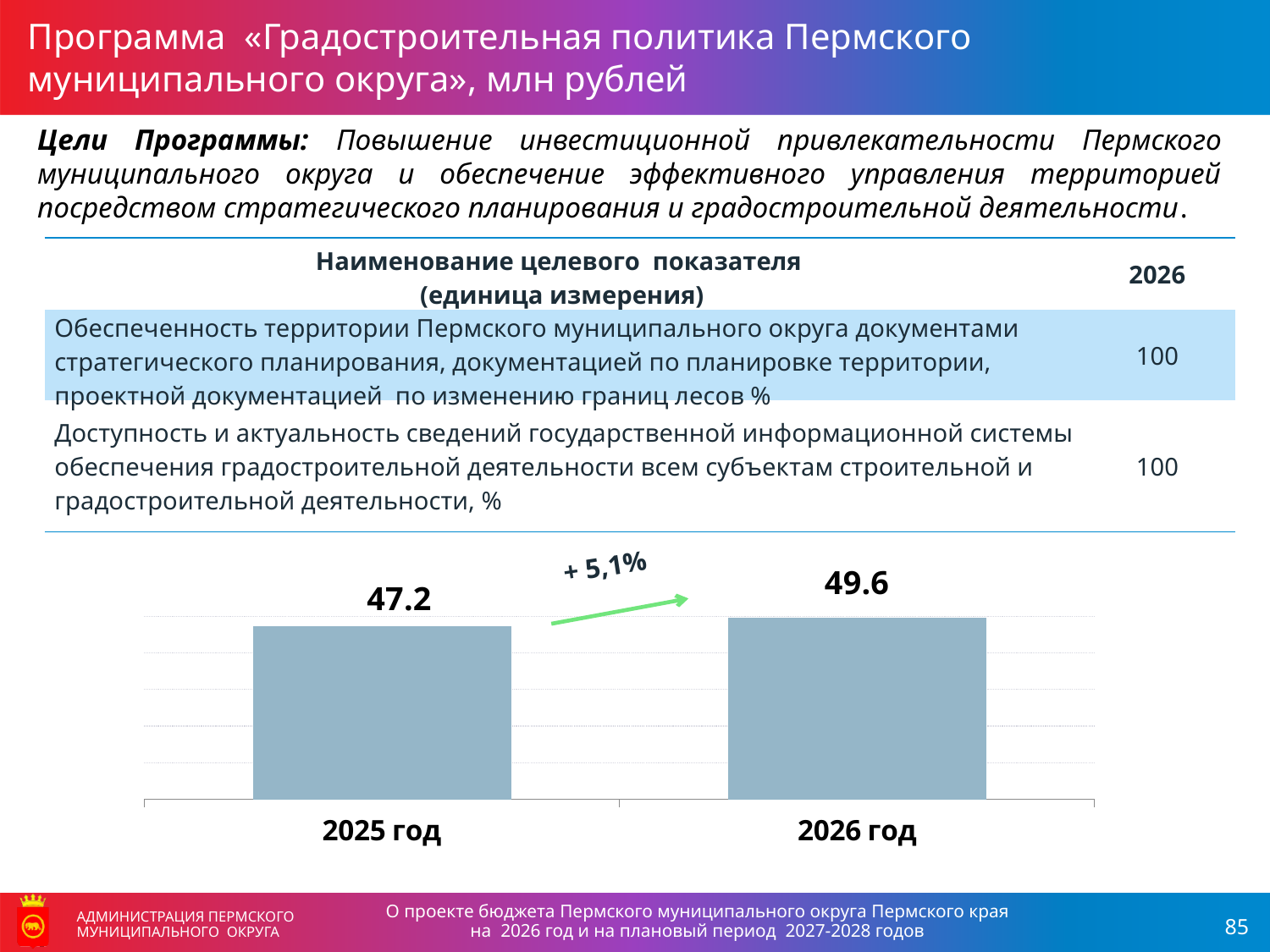
What is the value for 2026 год? 49.6 Which year has the lower value? 2025 год How many bars are shown in the chart? 2 Do the values rise or fall from 2025 год to 2026 год? rise What percentage change is annotated between the two bars? + 5,1% What is the value for 2025 год? 47.2 Which year has the higher value? 2026 год What kind of chart is shown on the slide? bar chart Is the value for 2026 год larger or smaller than the value for 2025 год? larger In what units are the chart values given, according to the slide title? млн рублей What is the difference between the values for 2026 год and 2025 год? 2.4